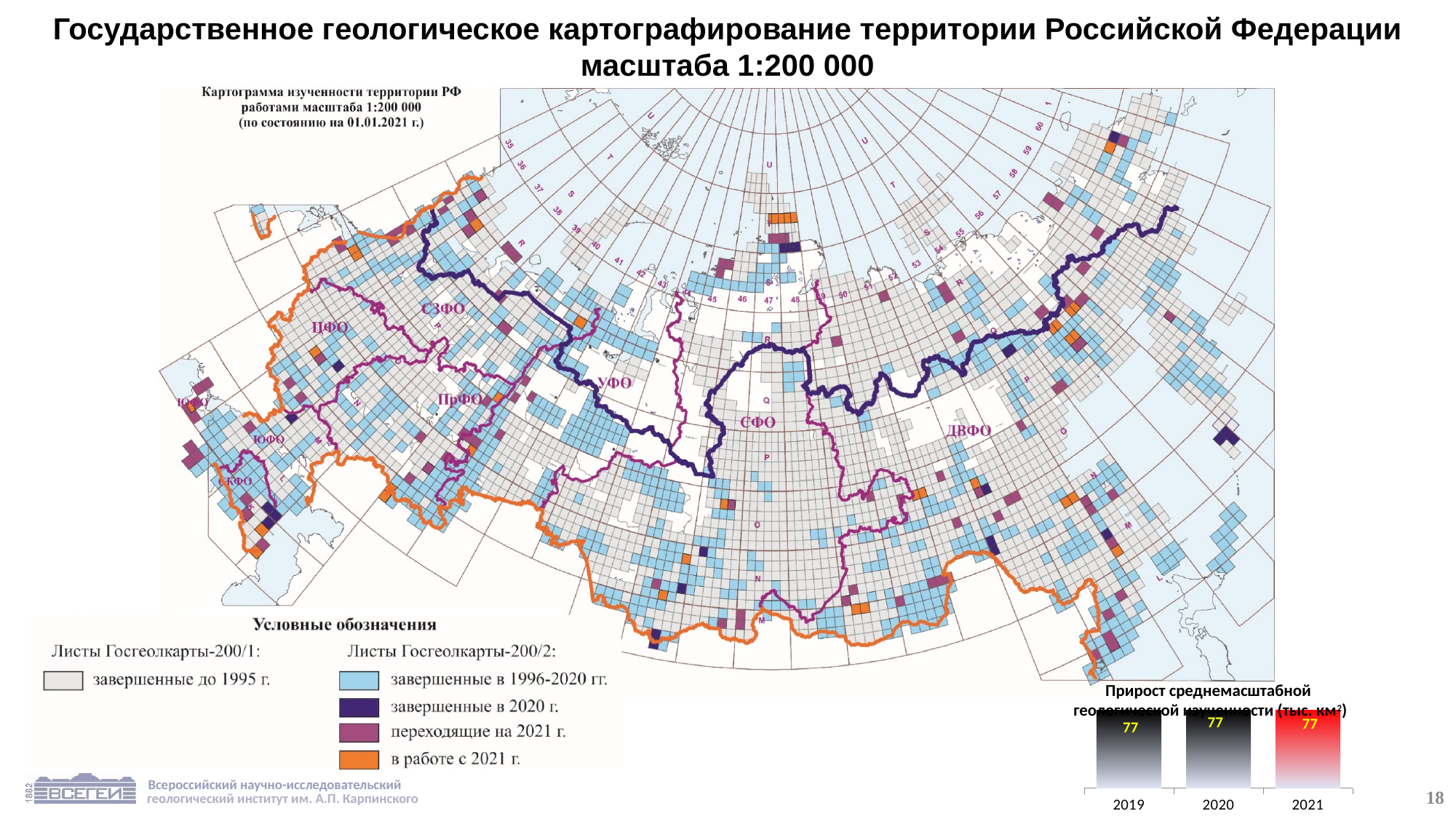
In the bar chart at the bottom right, what is the difference between the values for 2021 and 2019? 0 In the bar chart at the bottom right, which year's bar is coloured red? 2021 In the bar chart at the bottom right, is the value for 2020 larger than, smaller than or equal to the value for 2021? equal What is the value for 2019 in the bar chart at the bottom right of the slide? 77 What is the value for 2020 in the bar chart at the bottom right of the slide? 77 What is the value for 2021 in the bar chart at the bottom right of the slide? 77 What is the title of the bar chart at the bottom right of the slide? Прирост среднемасштабной геологической изученности (тыс. км²) In the bar chart at the bottom right, what is the total of the values for 2019, 2020 and 2021? 231 Which year is the first category on the x axis of the bar chart at the bottom right? 2019 In the bar chart at the bottom right, do the values rise, fall or stay the same from 2019 to 2021? stay the same How many years are shown in the bar chart at the bottom right of the slide? 3 What kind of chart is shown at the bottom right of the slide? bar chart